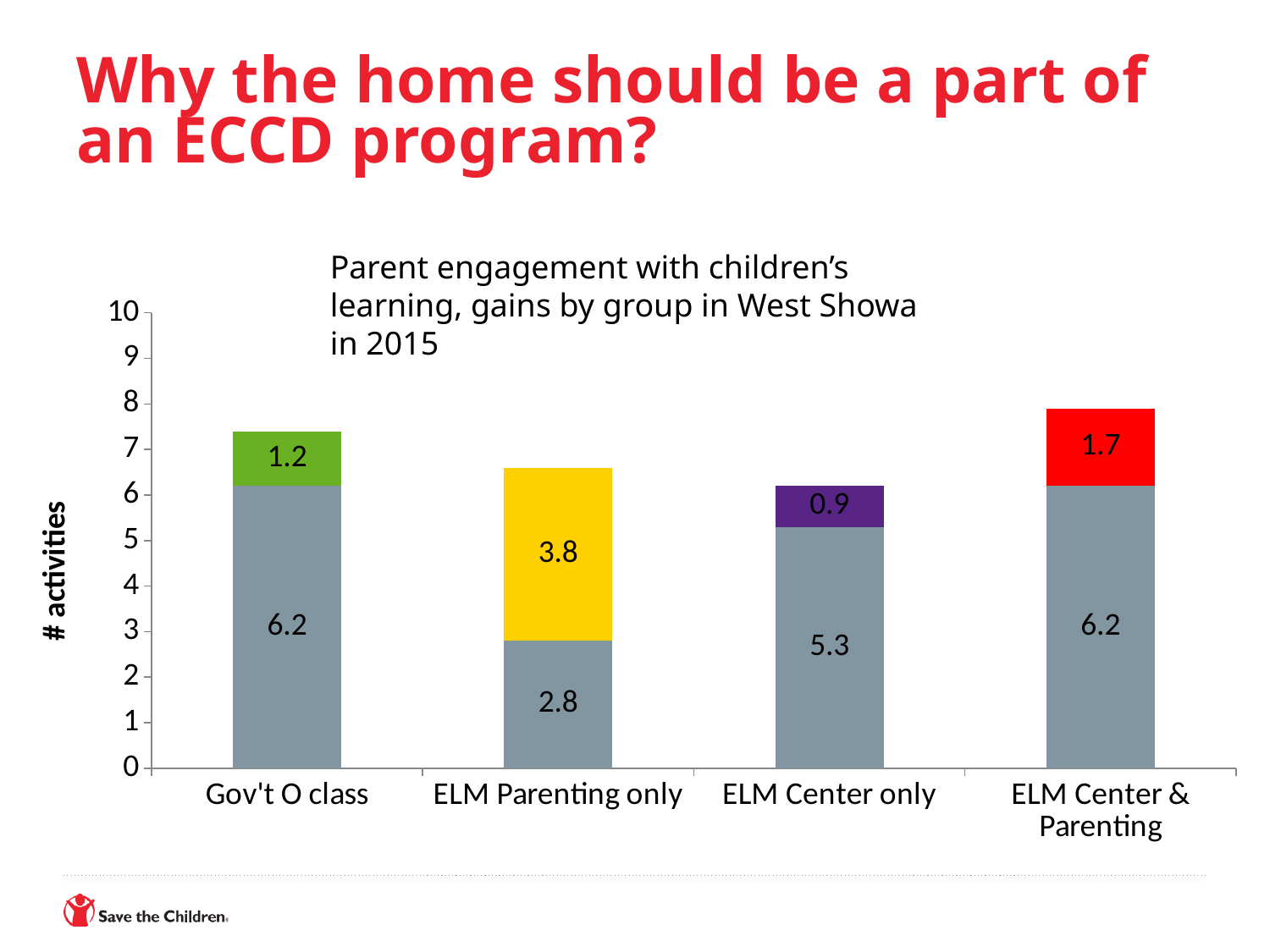
Which is larger: the top segment for Gov't O class or the top segment for ELM Center & Parenting? ELM Center & Parenting What is the difference between the top segment values for ELM Parenting only and ELM Center only? 2.9 What is the value of the coloured top segment for ELM Center & Parenting? 1.7 Which group has the smallest coloured top segment (gain)? ELM Center only What is the value of the grey bottom segment for ELM Center only? 5.3 How many groups (categories) are shown on the x axis? 4 What is the value of the grey bottom segment for ELM Parenting only? 2.8 What is the label on the y axis? # activities What is the total height of the stacked bar for ELM Center & Parenting? 7.9 What is the total height of the stacked bar for ELM Parenting only? 6.6 Which group has the largest coloured top segment (gain)? ELM Parenting only What kind of chart is shown on the slide? stacked bar chart